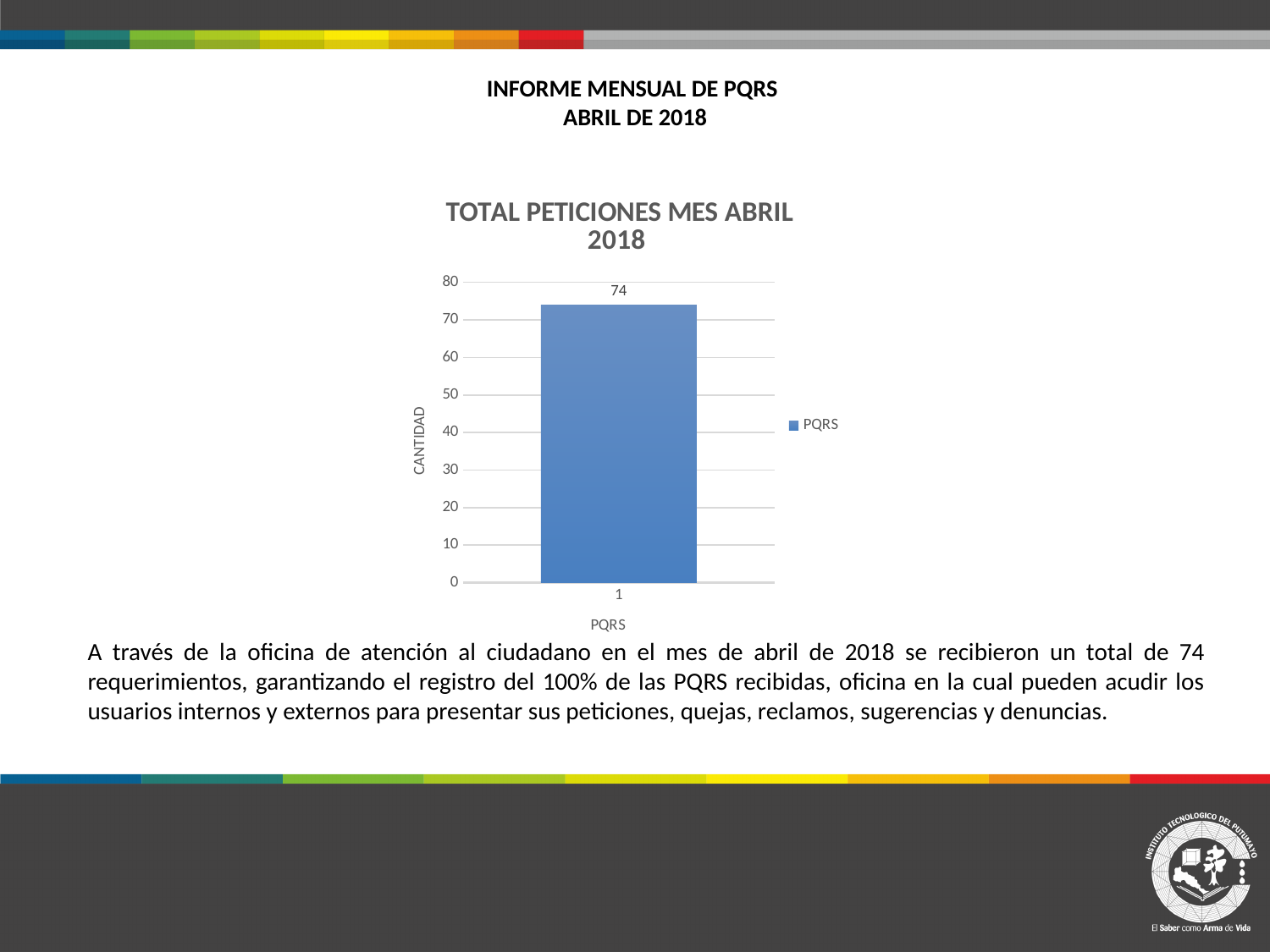
What is the title of the chart? TOTAL PETICIONES MES ABRIL 2018 What type of chart is shown on the slide? bar chart What category label appears below the bar on the horizontal axis? 1 Is the value of the PQRS bar greater or less than 80? less How many bars are plotted in the chart? 1 What is the label of the vertical axis of the chart? CANTIDAD How many series does the chart legend list? 1 Is the value of the PQRS bar greater or less than 70? greater What is the value of the PQRS bar in the chart? 74 What is the maximum value shown on the vertical axis of the chart? 80